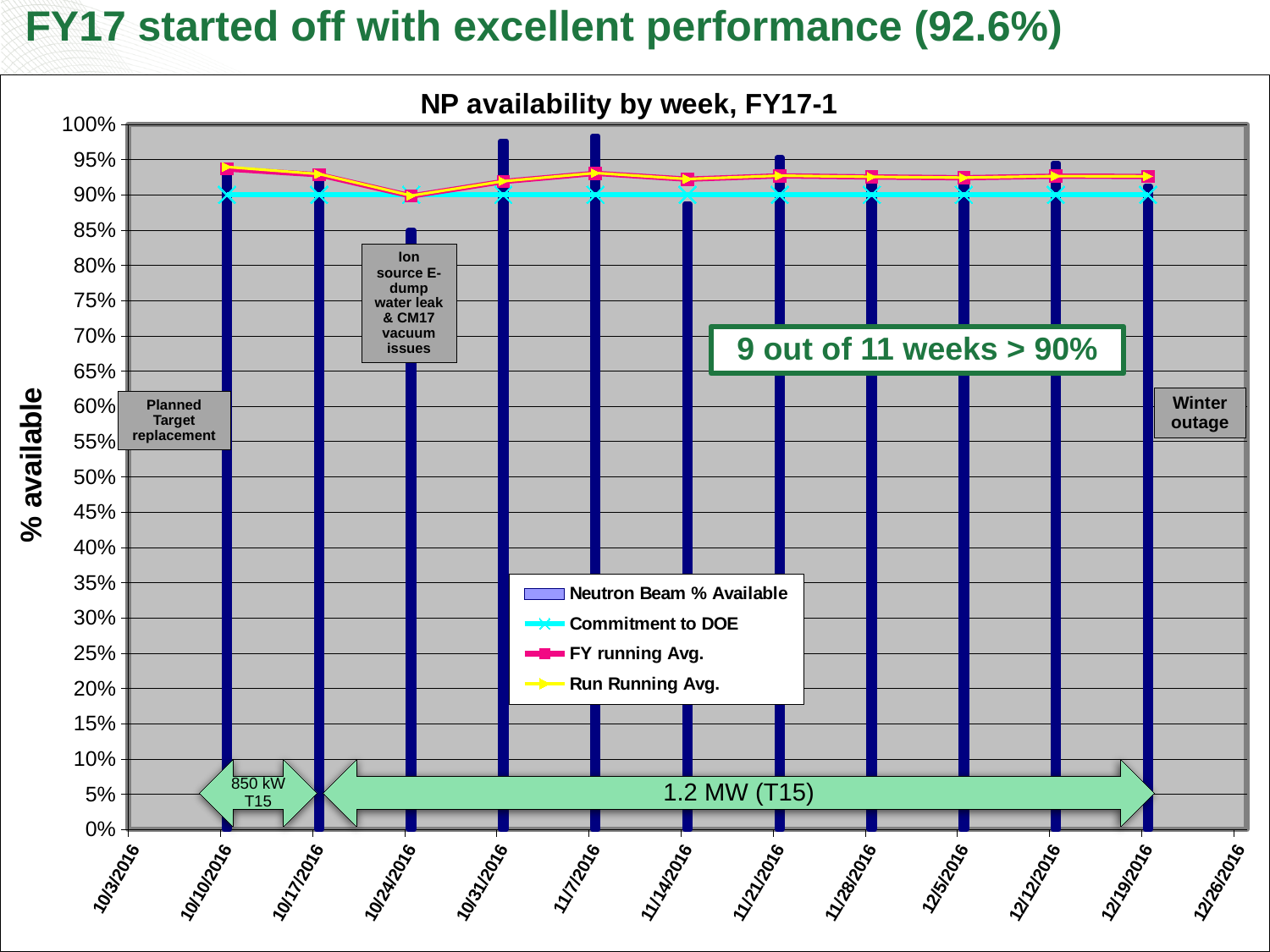
What kind of chart is used to show Neutron Beam % Available? bar chart Is the Neutron Beam % Available for 11/7/2016 greater or less than 95%? greater Which is larger, the Neutron Beam % Available for 11/7/2016 or for 11/21/2016? 11/7/2016 What is the label on the vertical axis of the chart? % available What is the title of the chart? NP availability by week, FY17-1 What value does the Commitment to DOE line sit at? 90% Which week has the lowest Neutron Beam % Available bar? 10/24/2016 How many series does the chart legend list? 4 Is the Neutron Beam % Available for 10/24/2016 greater or less than 90%? less Which is larger, the Neutron Beam % Available for 10/31/2016 or for 10/24/2016? 10/31/2016 How many weeks have a Neutron Beam % Available bar plotted? 11 Is the Neutron Beam % Available for 11/14/2016 greater or less than 95%? less